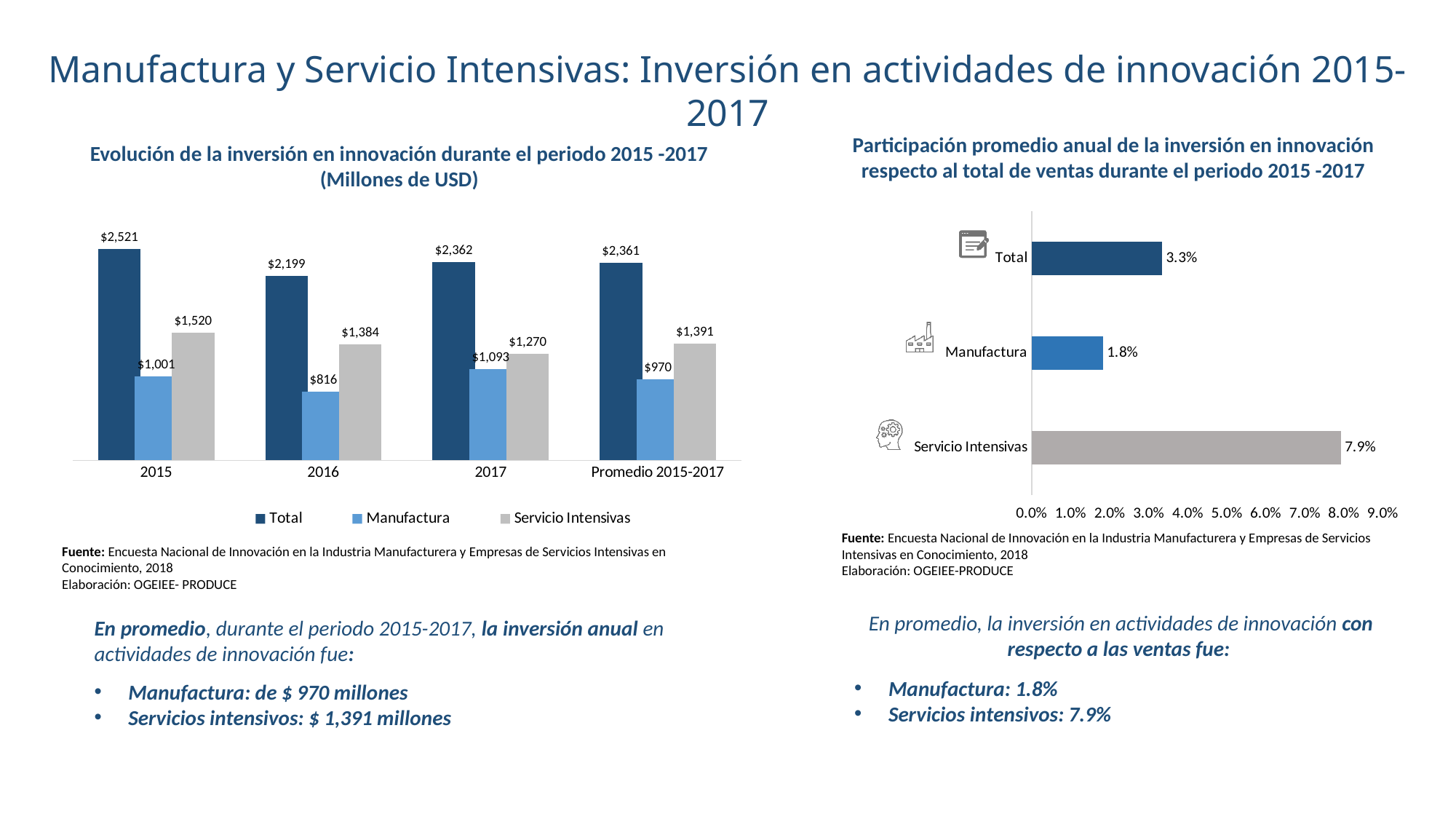
In the right chart (Participación promedio anual), which category has the lowest value? Manufactura In the left chart (Evolución de la inversión en innovación), which year has the highest Total value? 2015 In the left chart (Evolución de la inversión en innovación), what is the difference between the Servicio Intensivas and Manufactura values for 2015? $519 In the right chart (Participación promedio anual), what is the difference between the Servicio Intensivas and Total values? 4.6% In the left chart (Evolución de la inversión en innovación), which year has the lowest Manufactura value? 2016 In the left chart (Evolución de la inversión en innovación), what is the Manufactura value for 2016? $816 In the left chart (Evolución de la inversión en innovación), what is the Total value for 2015? $2,521 In the right chart (Participación promedio anual), what is the value for Servicio Intensivas? 7.9% In the left chart (Evolución de la inversión en innovación), how many categories are shown on the x axis? 4 What kind of chart is the right chart (Participación promedio anual)? Bar chart In the left chart (Evolución de la inversión en innovación), how many series does the legend list? 3 In the left chart (Evolución de la inversión en innovación), what is the Servicio Intensivas value for 2017? $1,270